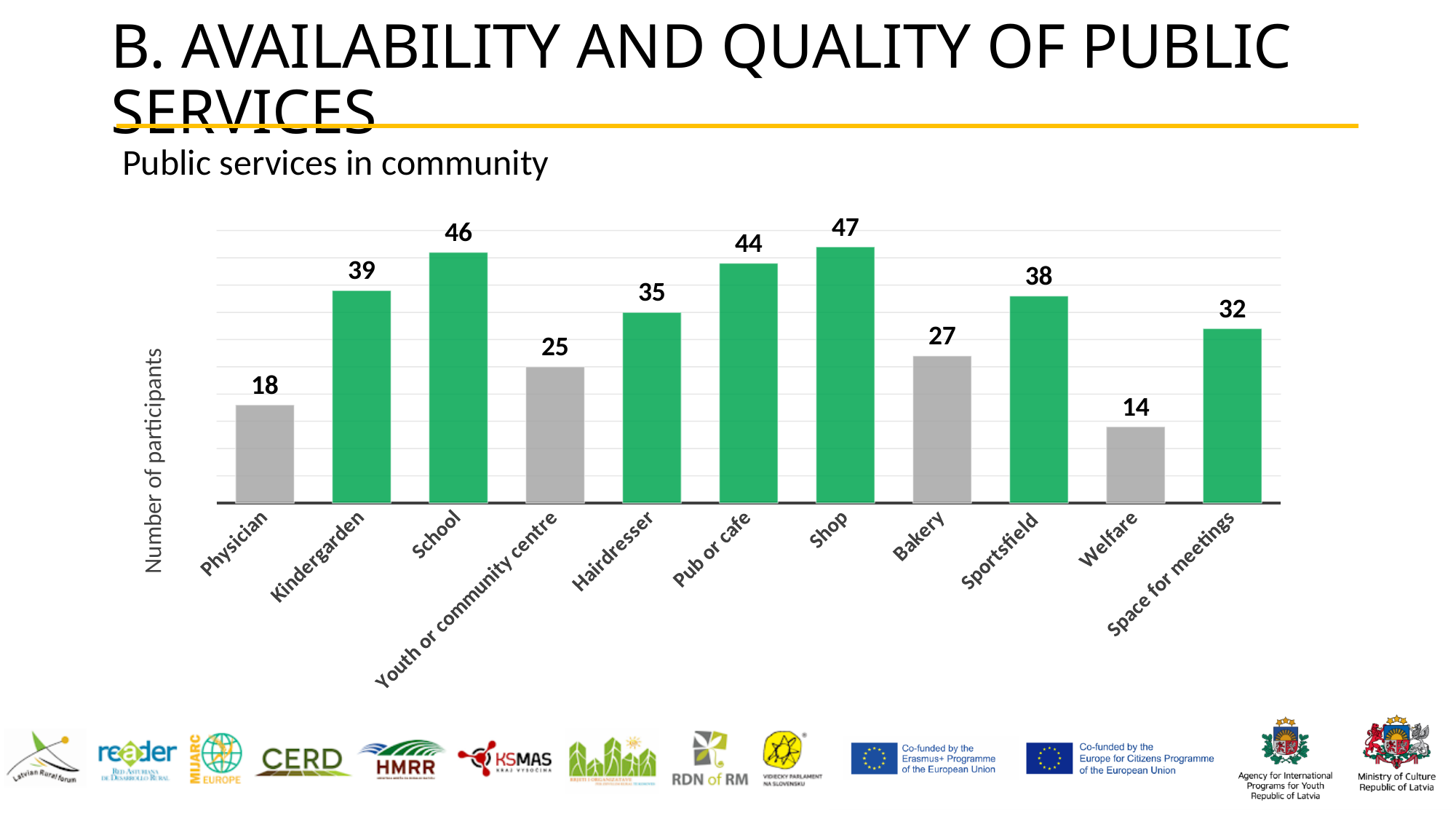
Which has more participants, Kindergarden or Sportsfield? Kindergarden What is the difference in number of participants between School and Physician? 28 Which category has the lowest number of participants? Welfare What is the label of the vertical axis? Number of participants What is the number of participants for Welfare? 14 What is the difference in number of participants between Pub or cafe and Bakery? 17 What is the number of participants for Shop? 47 What is the number of participants for Youth or community centre? 25 What colour are the bars for Physician, Youth or community centre, Bakery and Welfare? Grey What kind of chart is shown on the slide? Bar chart Which category has the highest number of participants? Shop How many categories are shown on the x axis? 11